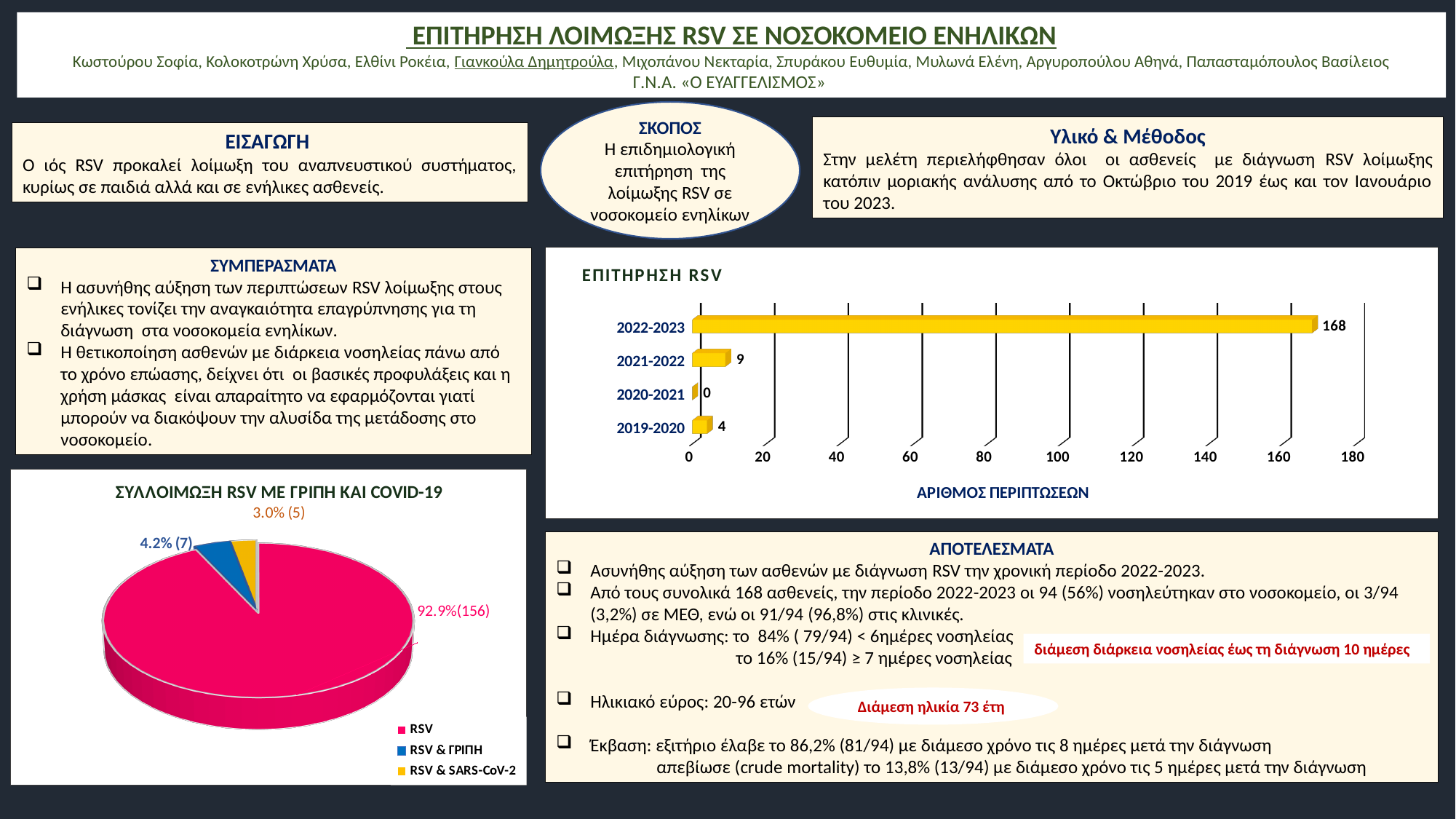
In the 'ΣΥΛΛΟΙΜΩΞΗ RSV ΜΕ ΓΡΙΠΗ ΚΑΙ COVID-19' pie chart, what percentage is shown for RSV & ΓΡΙΠΗ? 4.2% In the 'ΣΥΛΛΟΙΜΩΞΗ RSV ΜΕ ΓΡΙΠΗ ΚΑΙ COVID-19' pie chart, how many cases are shown for RSV & SARS-CoV-2? 5 In the 'ΕΠΙΤΗΡΗΣΗ RSV' chart, what is the number of cases for 2022-2023? 168 In the 'ΣΥΛΛΟΙΜΩΞΗ RSV ΜΕ ΓΡΙΠΗ ΚΑΙ COVID-19' pie chart, how many categories does the legend list? 3 In the 'ΕΠΙΤΗΡΗΣΗ RSV' chart, what is the label of the horizontal axis? ΑΡΙΘΜΟΣ ΠΕΡΙΠΤΩΣΕΩΝ What type of chart is the 'ΕΠΙΤΗΡΗΣΗ RSV' chart? Bar chart In the 'ΕΠΙΤΗΡΗΣΗ RSV' chart, how many periods are shown? 4 In the 'ΕΠΙΤΗΡΗΣΗ RSV' chart, which period has the lowest number of cases? 2020-2021 In the 'ΣΥΛΛΟΙΜΩΞΗ RSV ΜΕ ΓΡΙΠΗ ΚΑΙ COVID-19' pie chart, which slice is the largest? RSV In the 'ΕΠΙΤΗΡΗΣΗ RSV' chart, which period has the highest number of cases? 2022-2023 In the 'ΕΠΙΤΗΡΗΣΗ RSV' chart, what is the difference in cases between 2022-2023 and 2021-2022? 159 In the 'ΕΠΙΤΗΡΗΣΗ RSV' chart, what is the number of cases for 2019-2020? 4